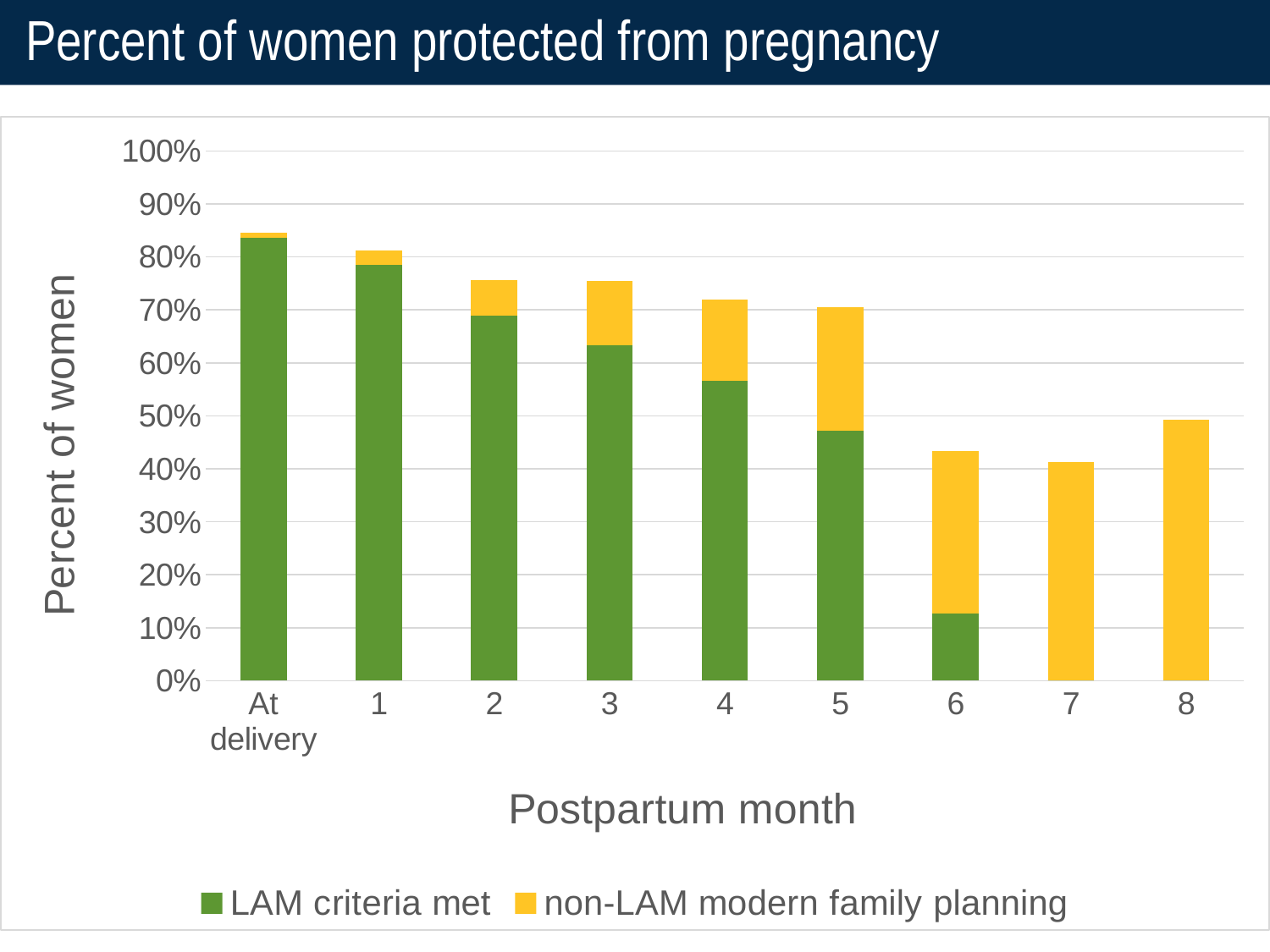
Is the 'LAM criteria met' value at delivery greater or less than 80%? greater Which postpartum time point has the highest total percent of women protected? At delivery How many series does the legend list? 2 Is the total percent of women protected larger at postpartum month 1 or month 5? Month 1 Does the 'LAM criteria met' series rise or fall from delivery through postpartum month 6? Fall Is the 'LAM criteria met' value at postpartum month 5 greater or less than 50%? less Which postpartum month has the smallest non-zero 'LAM criteria met' segment? 6 Is the 'LAM criteria met' value larger at postpartum month 2 or month 4? Month 2 What kind of chart is shown on the slide? Stacked bar chart How many categories are shown along the x axis? 9 What colour represents 'non-LAM modern family planning' in the chart? Yellow Is the total percent of women protected at postpartum month 6 greater or less than 40%? greater